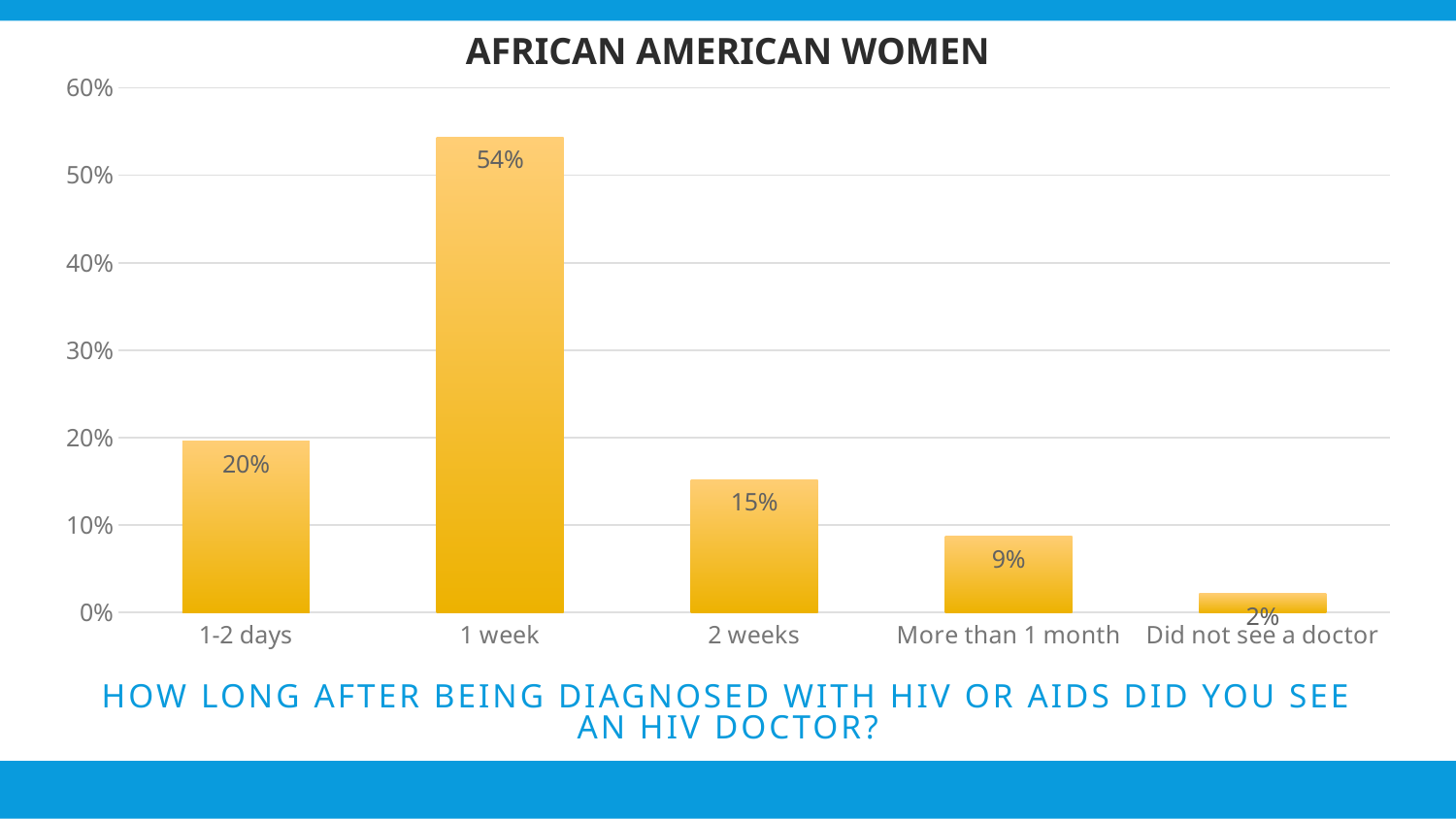
How many categories are shown on the x axis? 5 What percentage of African American women saw an HIV doctor 1 week after diagnosis? 54% Which is larger, the value for '1-2 days' or the value for '2 weeks'? 1-2 days What percentage is shown for 'More than 1 month'? 9% What is the value for the '1-2 days' category? 20% What is the title of the chart? AFRICAN AMERICAN WOMEN What kind of chart is shown on the slide? Bar chart What is the value for 'Did not see a doctor'? 2% What is the difference between the values for '1 week' and '2 weeks'? 39% Which category has the highest value? 1 week Is the value for '1 week' greater or less than 50%? greater Which category has the lowest value? Did not see a doctor